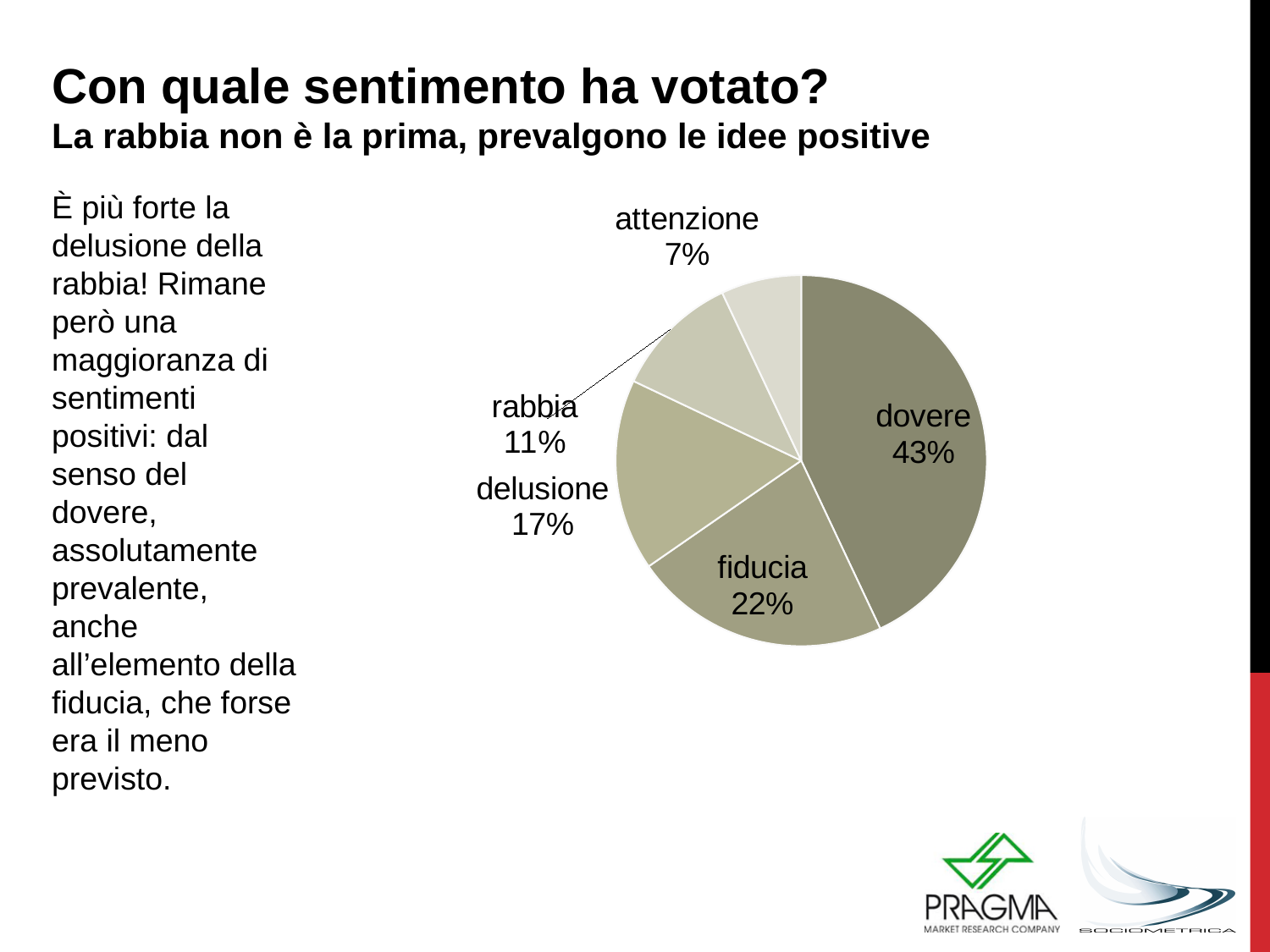
Which category has the largest slice of the pie? dovere What is the value shown for "attenzione"? 7% Which is larger, the slice for "delusione" or the slice for "rabbia"? delusione What share of the pie does "dovere" represent? 43% What is the difference in percentage points between "dovere" and "fiducia"? 21 How many slices does the pie chart have? 5 What is the value shown for "rabbia"? 11% What is the value shown for "delusione"? 17% What kind of chart is shown on the slide? pie chart What is the difference in percentage points between "rabbia" and "attenzione"? 4 What share of the pie does "fiducia" represent? 22% Which category has the smallest slice of the pie? attenzione